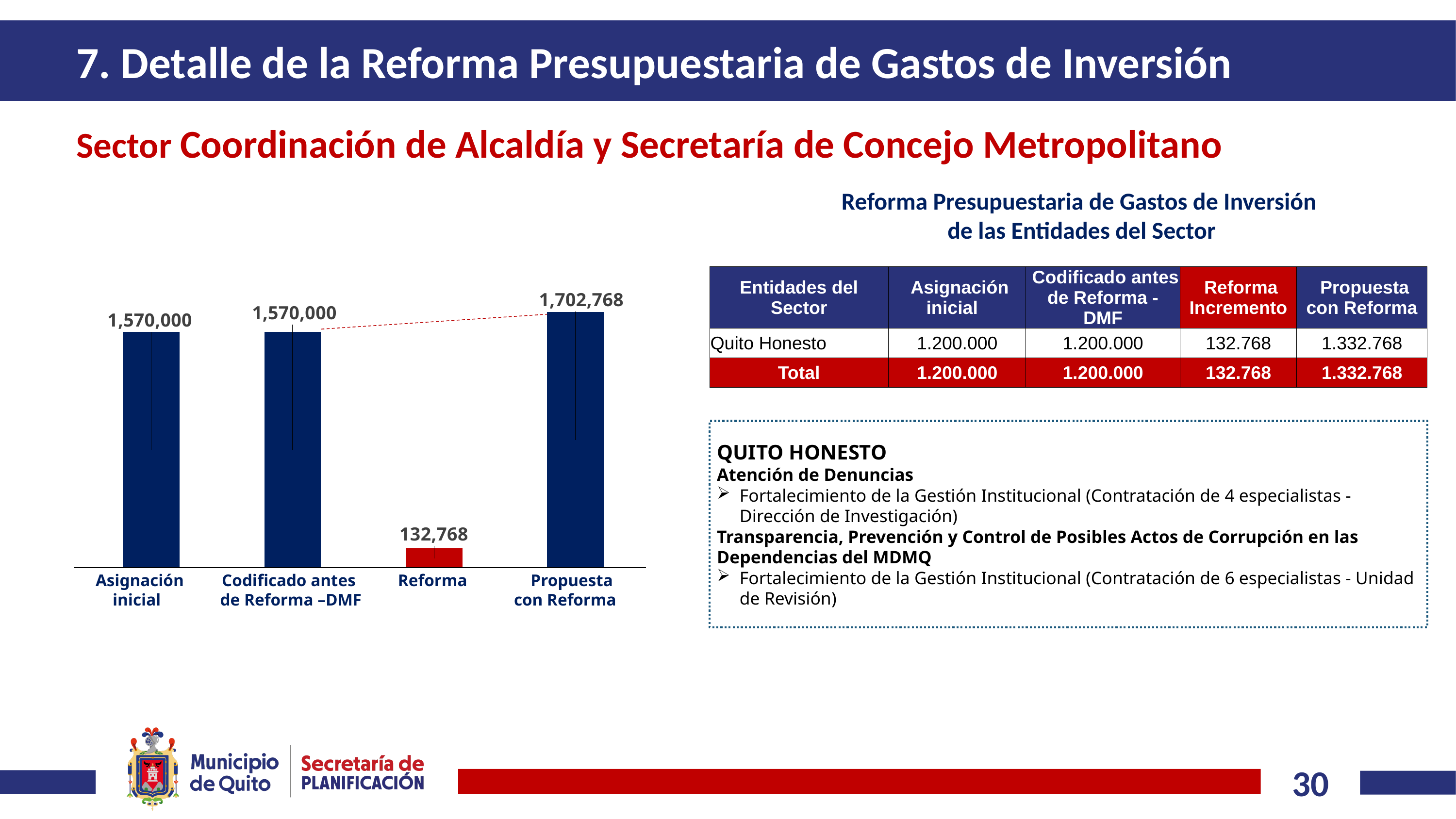
Which category has the highest value in the chart? Propuesta con Reforma What value is shown for the Propuesta con Reforma bar? 1,702,768 What value is shown for the Asignación inicial bar? 1,570,000 Which category has the lowest value in the chart? Reforma What is the difference between the Propuesta con Reforma value and the Codificado antes de Reforma –DMF value? 132,768 What value is shown for the Codificado antes de Reforma –DMF bar? 1,570,000 Which is larger, the value for Propuesta con Reforma or the value for Asignación inicial? Propuesta con Reforma What kind of chart is shown on the slide? Bar chart What is the difference between the Asignación inicial value and the Reforma value? 1,437,232 What colour is the Reforma bar? Red What value is shown for the Reforma bar? 132,768 How many bars are plotted in the chart? 4